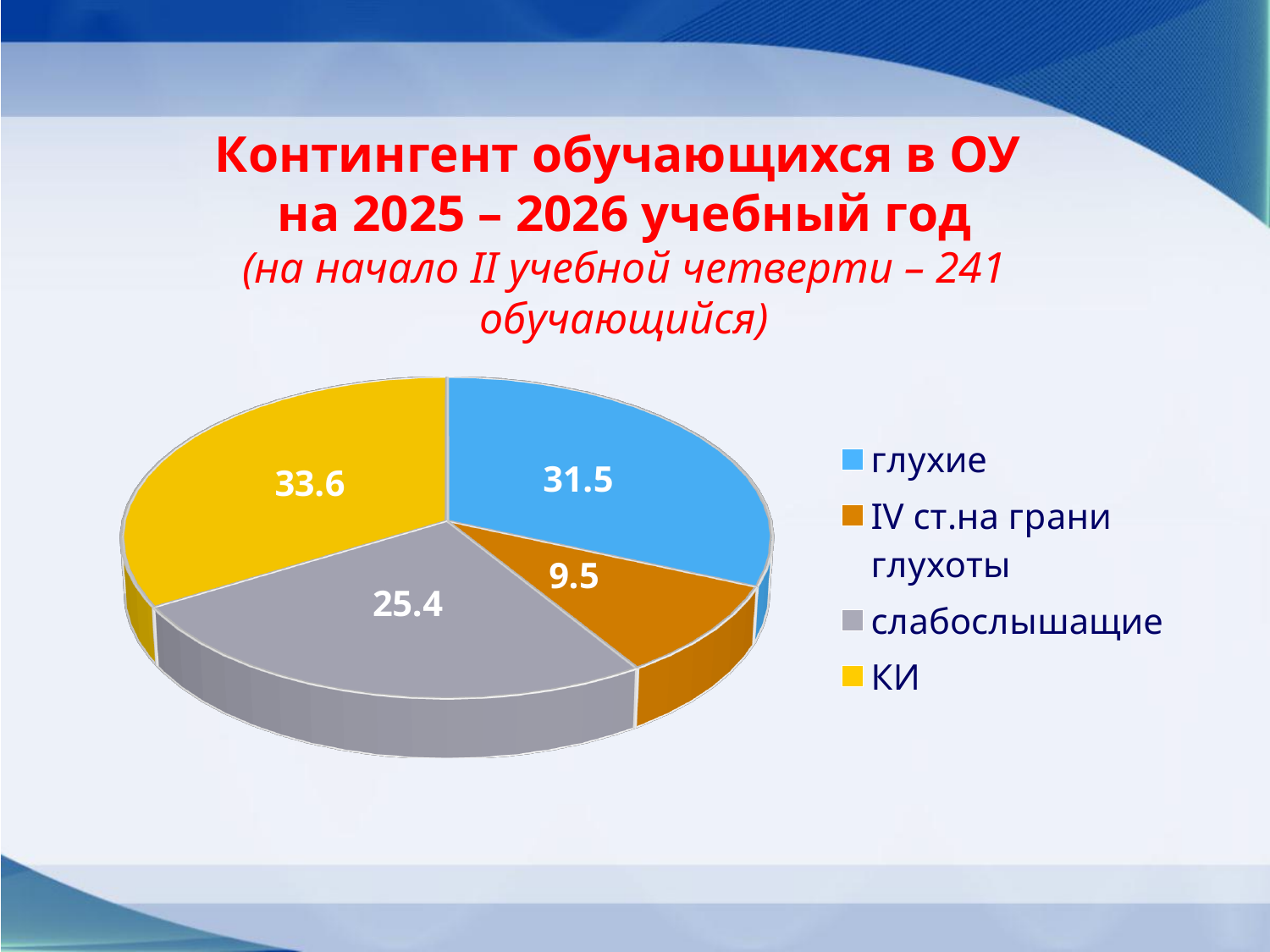
What kind of chart is shown on the slide? pie chart What colour is the "слабослышащие" slice? gray What is the value for the "IV ст.на грани глухоты" slice? 9.5 What is the value for the "слабослышащие" slice? 25.4 Which is larger, the value for "глухие" or the value for "слабослышащие"? глухие Which category has the smallest slice? IV ст.на грани глухоты What is the difference between the values for "слабослышащие" and "IV ст.на грани глухоты"? 15.9 What is the value for the "КИ" slice? 33.6 Which category has the largest slice? КИ How many slices does the pie chart have? 4 What is the difference between the values for "КИ" and "глухие"? 2.1 What is the value for the "глухие" slice? 31.5